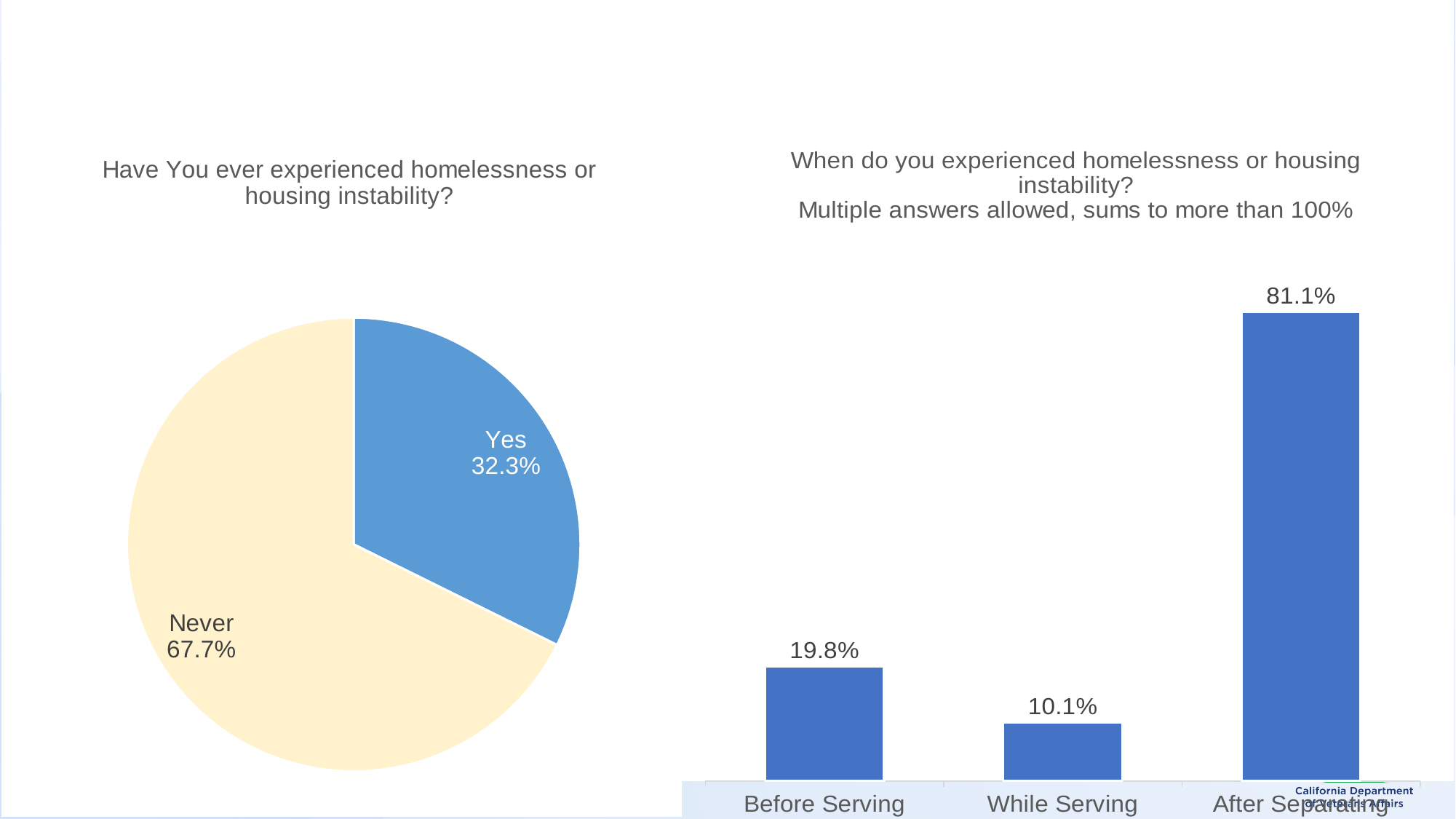
In the bar chart on the right, which category has the highest value? After Separating In the pie chart on the left, what is the difference between the Never and Yes shares? 35.4% In the bar chart 'When do you experienced homelessness or housing instability?', what is the value for After Separating? 81.1% In the bar chart 'When do you experienced homelessness or housing instability?', what is the value for While Serving? 10.1% In the pie chart 'Have You ever experienced homelessness or housing instability?', what percentage answered Never? 67.7% In the pie chart 'Have You ever experienced homelessness or housing instability?', what percentage answered Yes? 32.3% How many slices does the pie chart on the left have? 2 In the pie chart on the left, which slice is larger, Yes or Never? Never What type of chart is on the left side of the slide? Pie chart In the bar chart on the right, what is the difference between After Separating and Before Serving? 61.3% In the bar chart on the right, which category has the lowest value? While Serving In the bar chart 'When do you experienced homelessness or housing instability?', what is the value for Before Serving? 19.8%